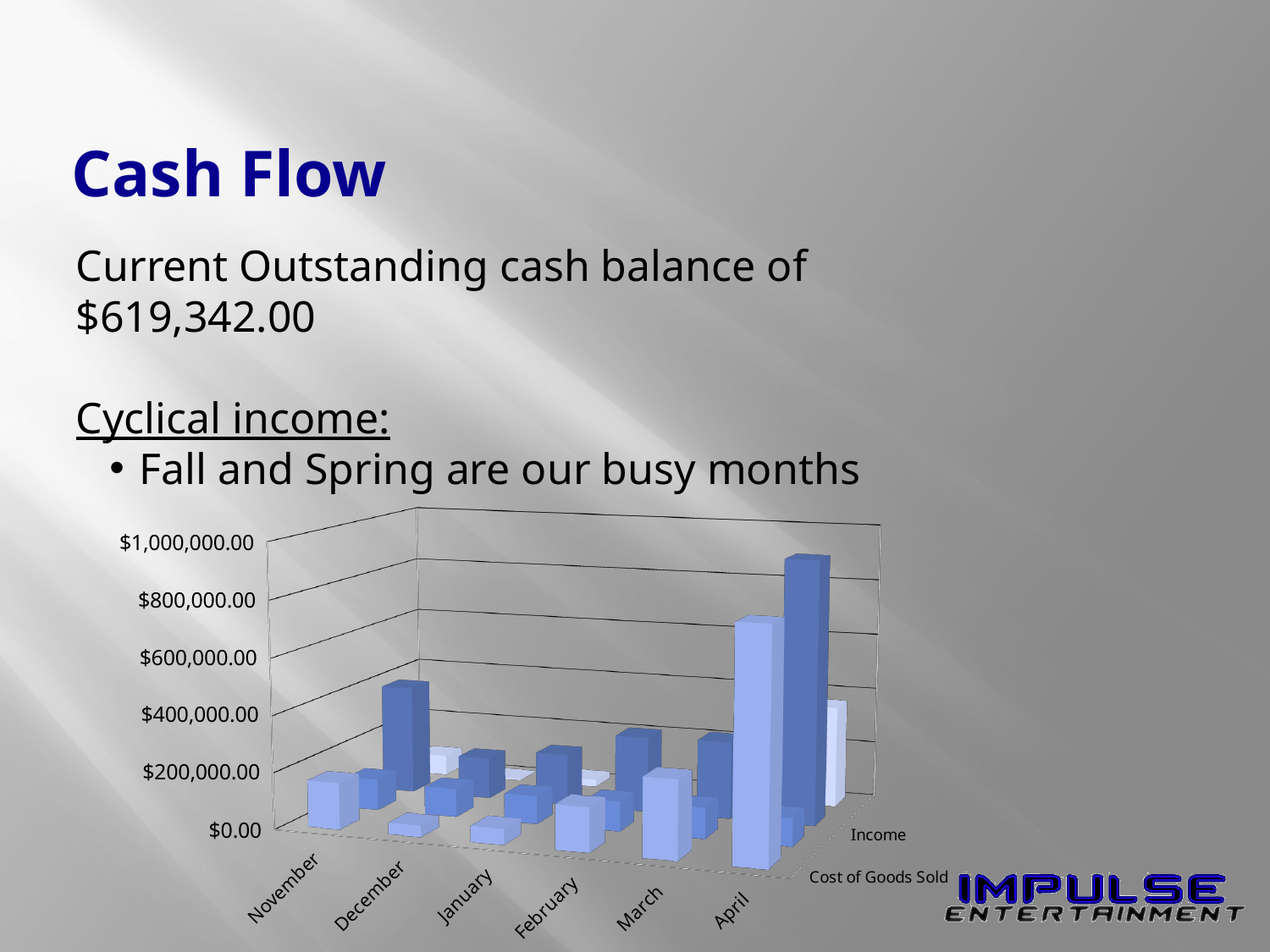
What kind of chart is shown on the slide? bar chart Is the front-row bar for January greater or less than $200,000.00? less Is the front-row bar for November greater or less than $400,000.00? less What is the highest value labelled on the vertical axis of the chart? $1,000,000.00 How many months are shown along the x axis of the chart? 6 Is the tallest bar for April greater or less than $600,000.00? greater Which month is the first category on the x axis of the chart? November Which month has the tallest bar in the chart? April